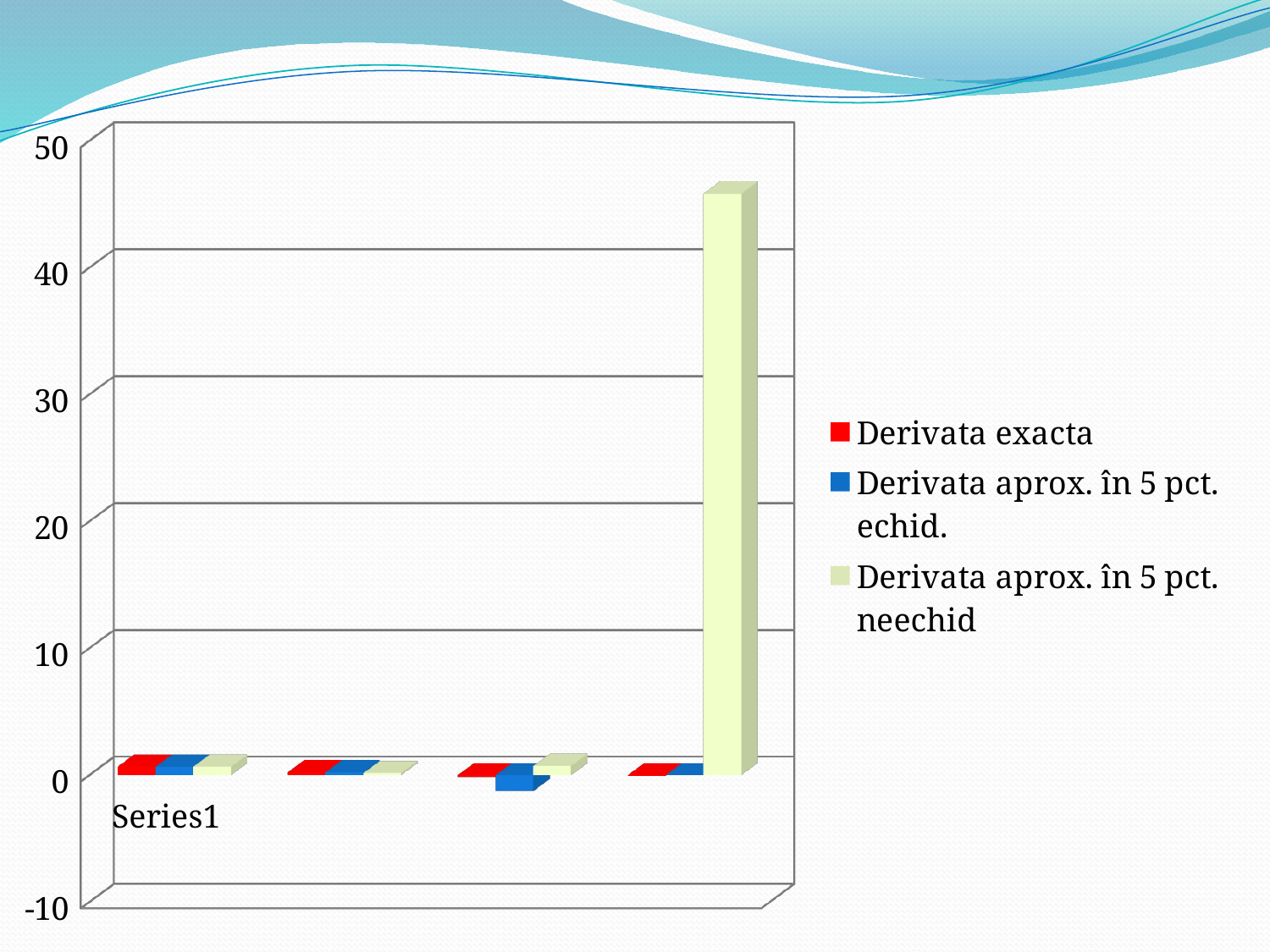
Which series has a bar that drops below 0 in the third group of bars? Derivata aprox. în 5 pct. echid. What kind of chart is shown on the slide? bar chart Is the tallest bar on the chart greater or less than 50? less Which series is shown in red in the legend? Derivata exacta In the fourth group of bars, is the bar for Derivata aprox. în 5 pct. neechid larger than the bar for Derivata exacta? yes How many groups of bars are plotted on the chart? 4 Which series is shown in blue in the legend? Derivata aprox. în 5 pct. echid. What is the highest value shown on the vertical axis? 50 How many series does the legend list? 3 Which series has the tallest bar on the chart? Derivata aprox. în 5 pct. neechid Is the tallest bar on the chart greater or less than 40? greater